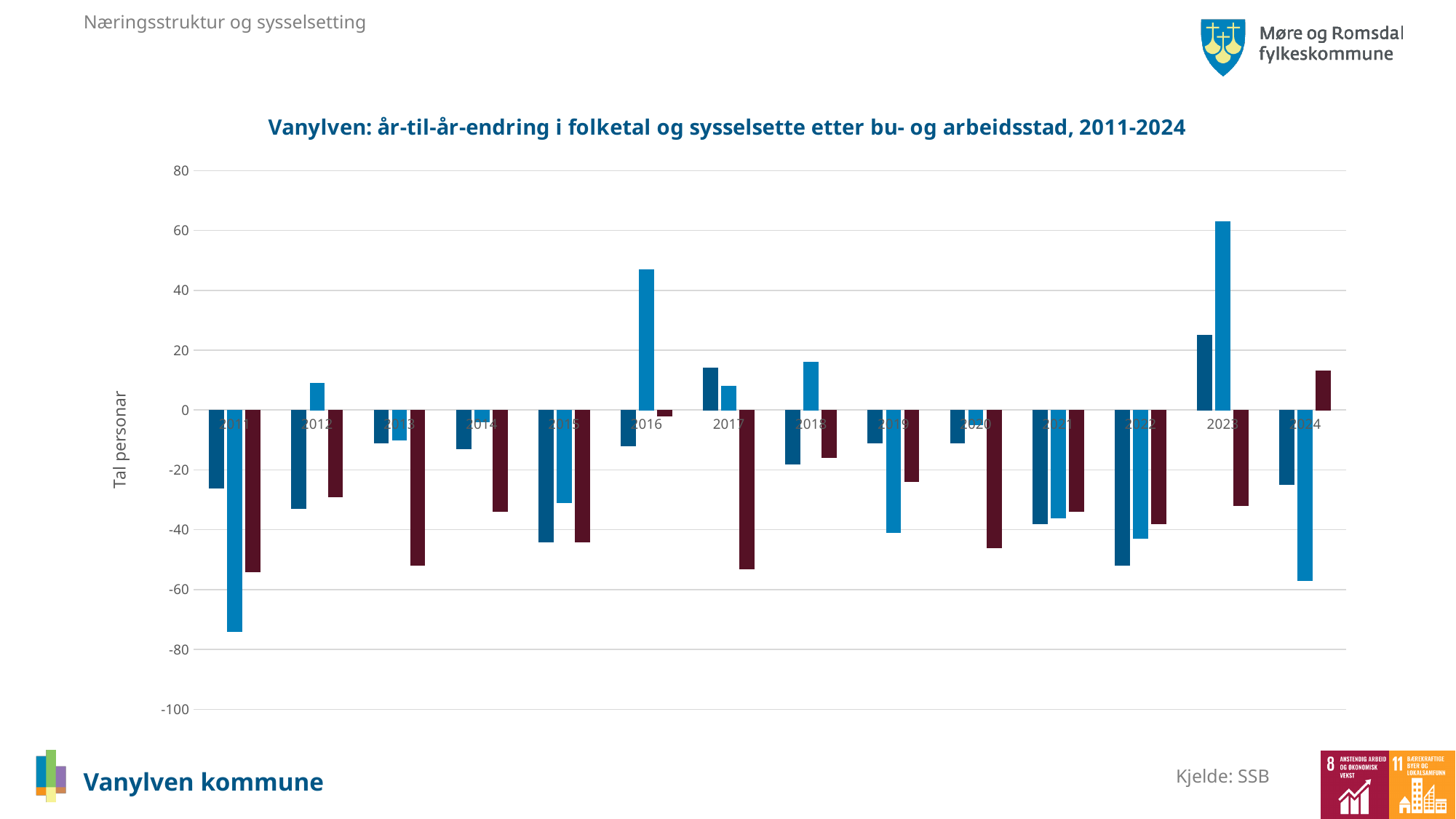
What type of chart is shown on the slide? bar chart Is the value of the light blue bar for 2011 greater or less than -60? less Which is larger, the light blue bar for 2016 or the light blue bar for 2023? 2023 In which year does the light blue bar reach its lowest value? 2011 In which year does the light blue bar reach its highest value? 2023 Is the value of the light blue bar for 2024 greater or less than -40? less Is the value of the dark red bar for 2017 greater or less than -40? less How many years are shown along the x axis of the chart? 14 What is the label on the vertical axis of the chart? Tal personar What is the title of the chart? Vanylven: år-til-år-endring i folketal og sysselsette etter bu- og arbeidsstad, 2011-2024 How many bars are plotted for each year in the chart? 3